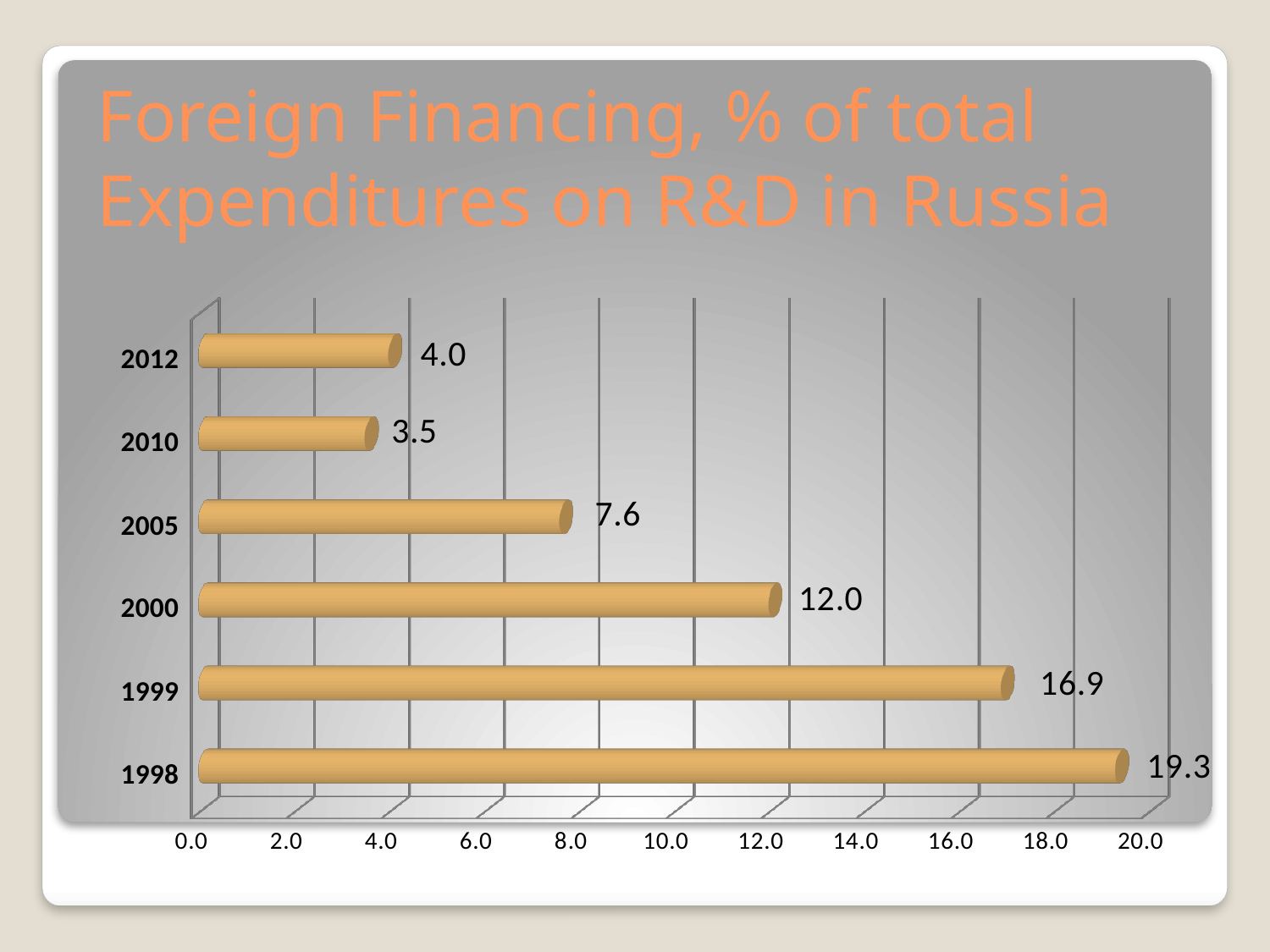
What is the value for 2012? 4.0 Which is larger, the value for 2005 or the value for 2010? 2005 What is the title of the chart? Foreign Financing, % of total Expenditures on R&D in Russia What is the difference between the values for 1998 and 2012? 15.3 How many years are shown in the chart? 6 What is the value for 1998? 19.3 What kind of chart is shown on the slide? bar chart Which year has the highest value? 1998 Which year has the lowest value? 2010 What is the difference between the values for 1999 and 2000? 4.9 What is the value for 2005? 7.6 Is the value for 2000 greater or less than 10.0? greater